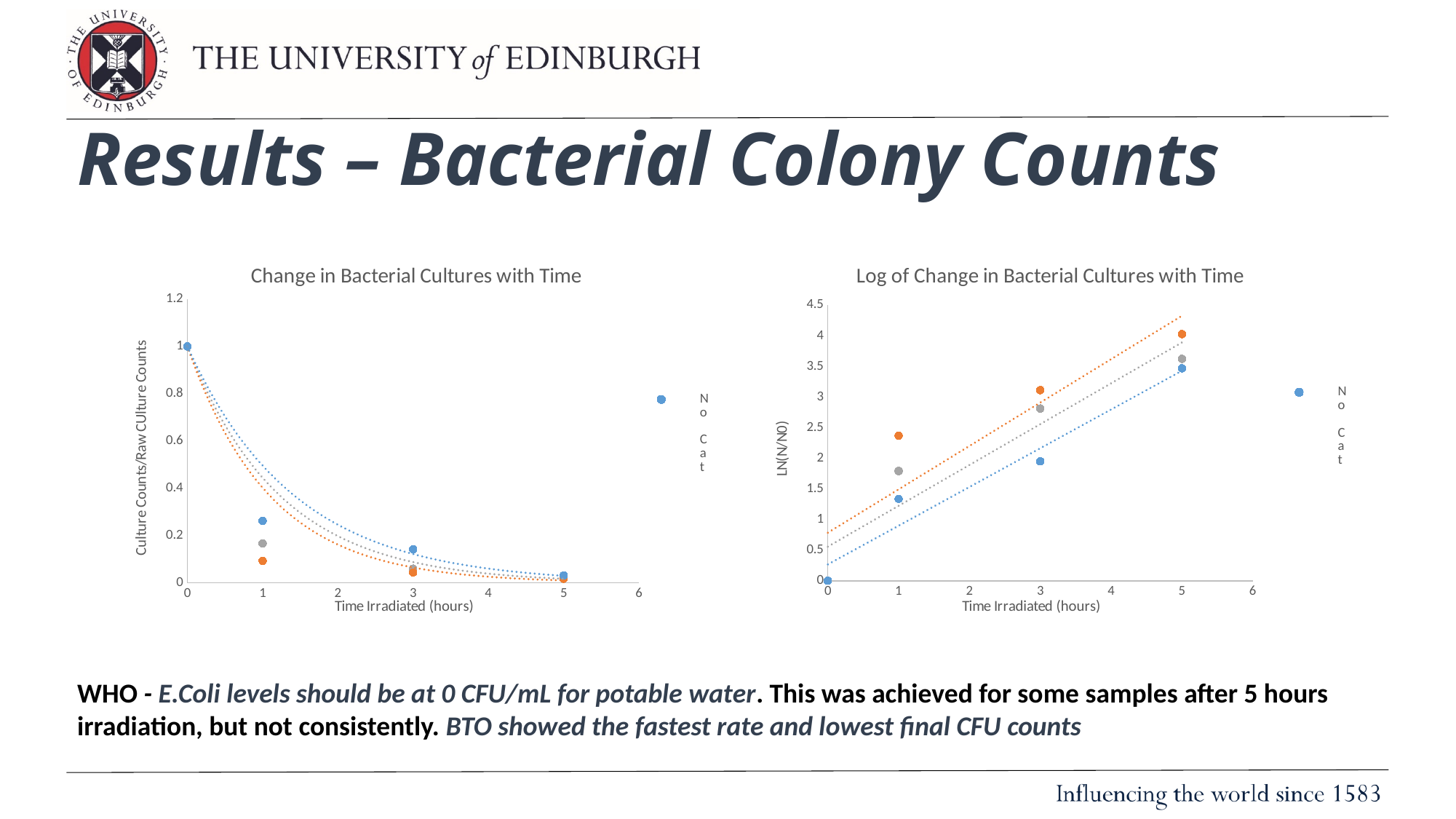
In the chart 'Change in Bacterial Cultures with Time', is the orange point at 1 hour greater or less than 0.2? less In the chart 'Change in Bacterial Cultures with Time', do the values rise or fall as time irradiated increases? fall In the chart 'Log of Change in Bacterial Cultures with Time', is the orange point at 1 hour greater or less than 2? greater How many time points are plotted along the x axis in the chart 'Change in Bacterial Cultures with Time'? 4 In the chart 'Log of Change in Bacterial Cultures with Time', do the values rise or fall as time irradiated increases? rise What is the x-axis label of the chart 'Change in Bacterial Cultures with Time'? Time Irradiated (hours) What is the y-axis label of the chart 'Log of Change in Bacterial Cultures with Time'? LN(N/N0) In the chart 'Change in Bacterial Cultures with Time', is the blue point at 1 hour greater or less than 0.2? greater What type of chart is 'Change in Bacterial Cultures with Time'? scatter chart In the chart 'Change in Bacterial Cultures with Time', which is higher at 1 hour, the blue point or the orange point? blue In the chart 'Log of Change in Bacterial Cultures with Time', which is higher at 1 hour, the orange point or the blue point? orange